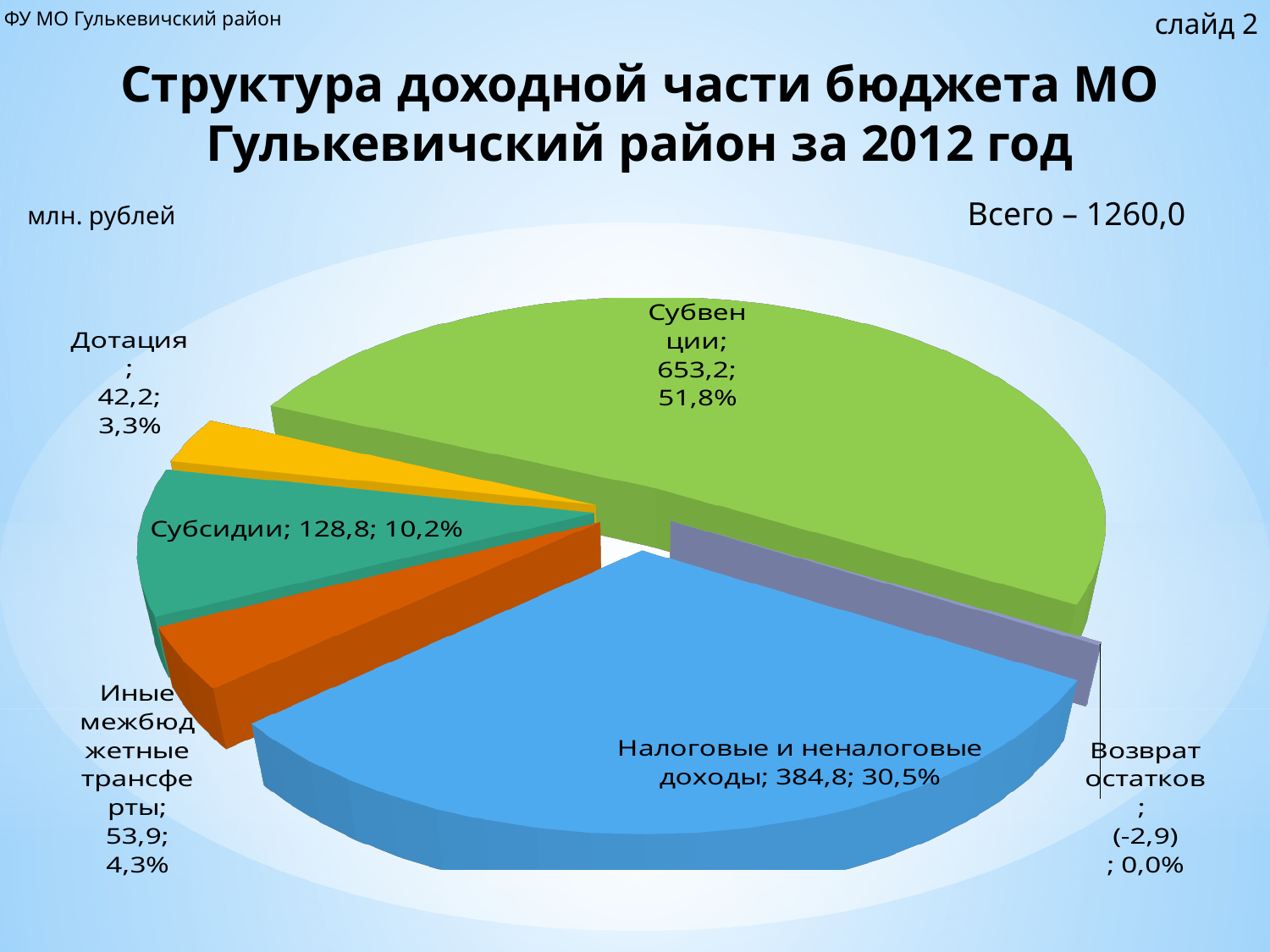
What is the value for Субсидии? 128,8 What is the value for Иные межбюджетные трансферты? 53,9 Which is larger, the value for Субсидии or the value for Дотация? Субсидии What is the difference between the values for Субвенции and Налоговые и неналоговые доходы? 268,4 What is the value for Субвенции? 653,2 What kind of chart is shown on the slide? pie chart Which category has the smallest value? Возврат остатков How many categories are shown in the pie chart? 6 What total is stated on the slide for the budget revenue? 1260,0 Which category has the largest slice of the pie? Субвенции What share of the pie does Дотация represent? 3,3% What share of the pie does Налоговые и неналоговые доходы represent? 30,5%